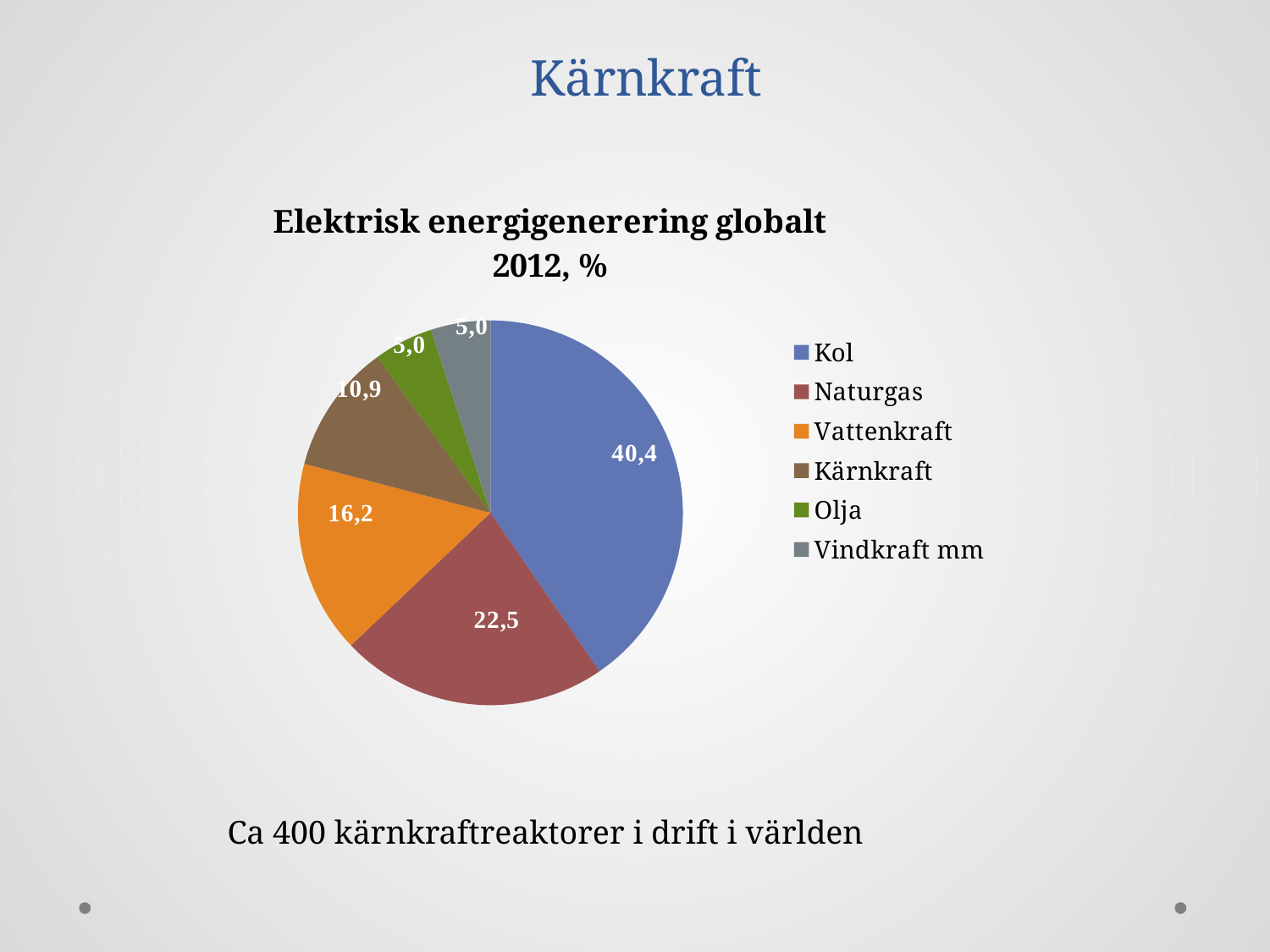
Which category has the largest slice? Kol What is the difference between the values for Vattenkraft and Kärnkraft? 5,3 What is the value for Vattenkraft? 16,2 How many categories does the legend list? 6 What is the value for Kol? 40,4 What type of chart is shown on the slide? pie chart Which is larger, the value for Naturgas or the value for Vattenkraft? Naturgas What is the title of the chart? Elektrisk energigenerering globalt 2012, % What share of the pie does Kol represent? 40,4% What is the difference between the values for Kol and Naturgas? 17,9 What is the value for Naturgas? 22,5 What is the value for Kärnkraft? 10,9